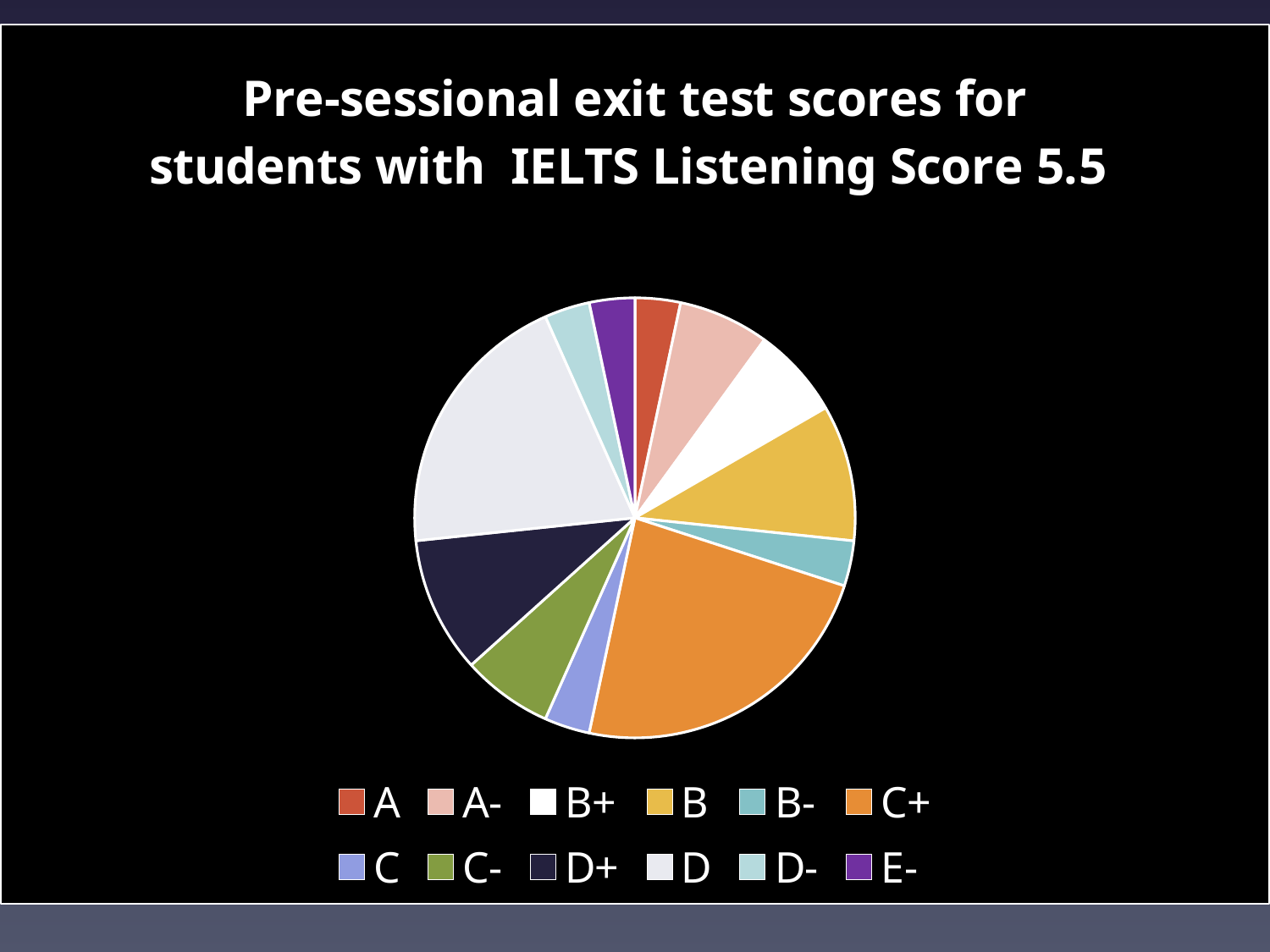
Which category is shown in orange in the legend? C+ How many categories does the pie chart show? 12 Which slice is larger, C+ or D? C+ Which category has the largest slice of the pie? C+ Which slice is larger, C+ or B? C+ Which slice is larger, D+ or C-? D+ What kind of chart is shown on the slide? pie chart What is the title of the chart? Pre-sessional exit test scores for students with IELTS Listening Score 5.5